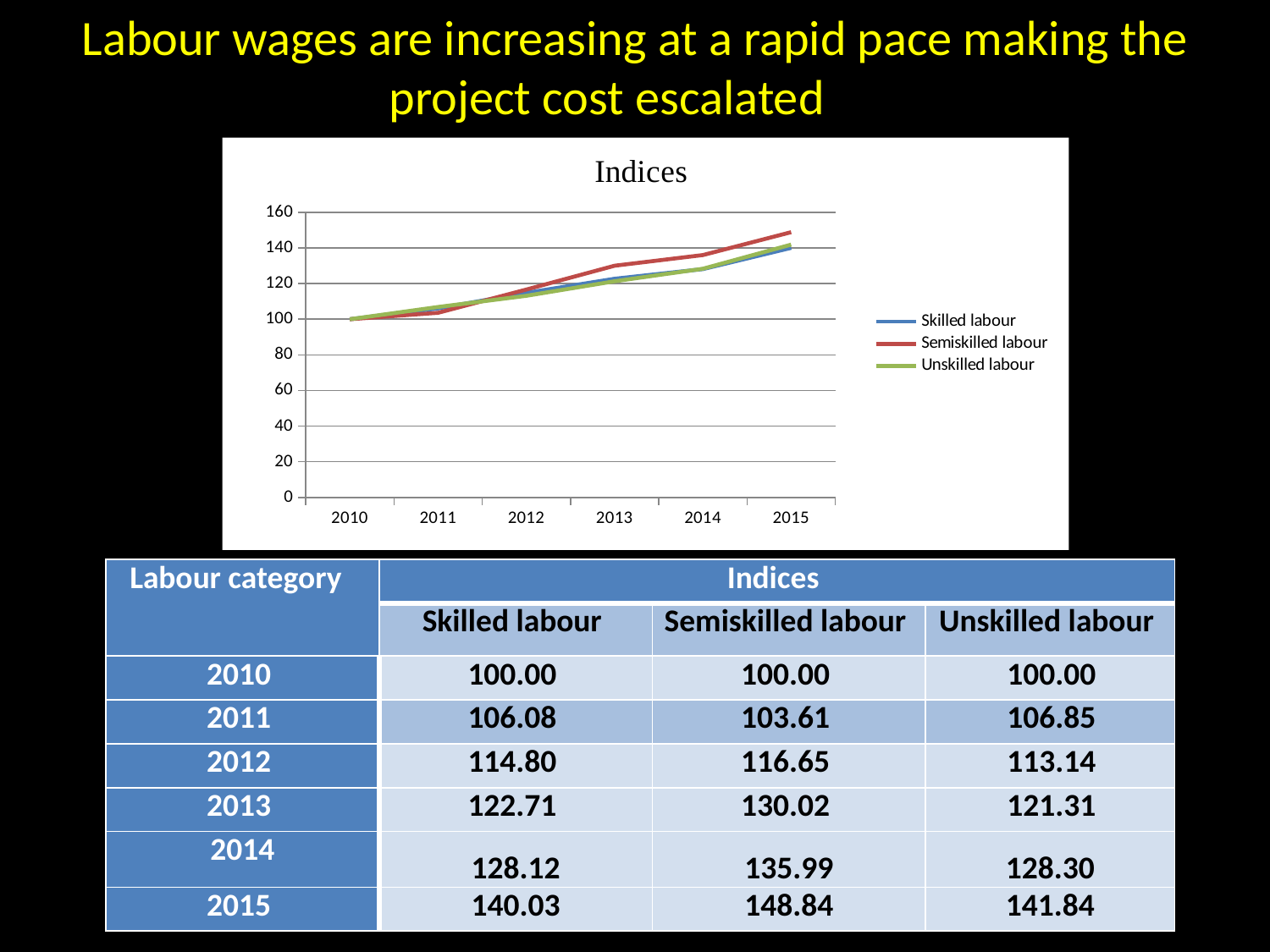
Which labour category has the highest index in 2015? Semiskilled labour What is the title of the chart? Indices Which labour category has the lowest index in 2011? Semiskilled labour How many series does the chart legend list? 3 What is the index value for Skilled labour in 2013? 122.71 How many years are plotted along the x axis of the chart? 6 Which series is drawn in red on the chart? Semiskilled labour Is the Semiskilled labour index in 2015 greater or less than 140? greater Do the index values for Skilled labour rise or fall from 2010 to 2015? rise What is the index value for Semiskilled labour in 2015? 148.84 What kind of chart is shown on the slide? line chart What is the difference between the Semiskilled labour index and the Skilled labour index in 2015? 8.81